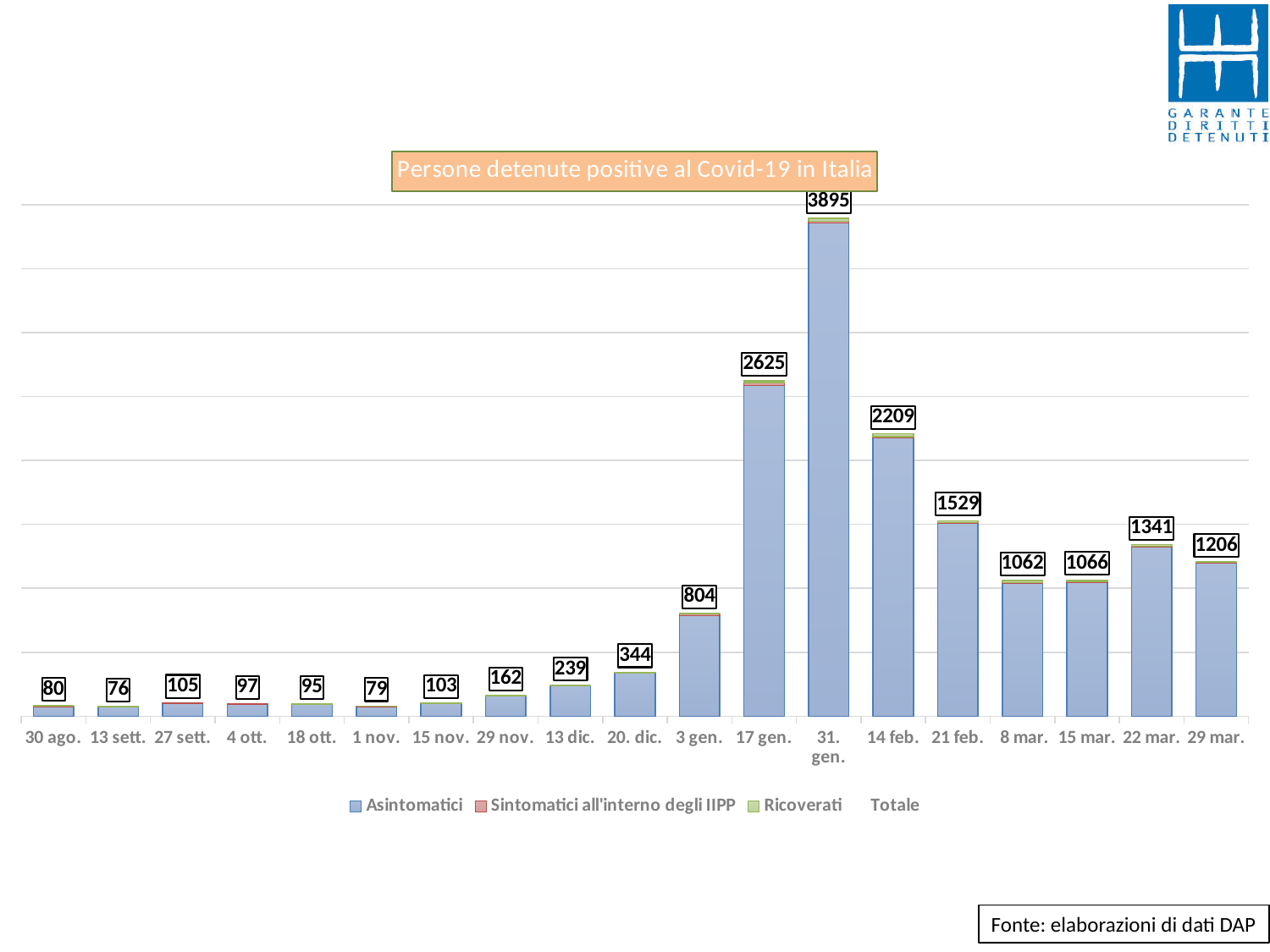
What is the difference between the totals for 22 mar. and 29 mar.? 135 What is the title of the chart? Persone detenute positive al Covid-19 in Italia Which date has the lowest total of positive detainees? 13 sett. What is the total number of positive detainees shown for 31. gen.? 3895 Which date has the highest total of positive detainees? 31. gen. How many dates are shown on the x axis? 19 What kind of chart is shown on the slide? Stacked bar chart What is the total value labelled for 17 gen.? 2625 What is the total value labelled for 29 mar.? 1206 How many entries does the legend list? 4 What is the difference between the totals for 31. gen. and 17 gen.? 1270 Which is larger, the total for 8 mar. or the total for 15 mar.? 15 mar.